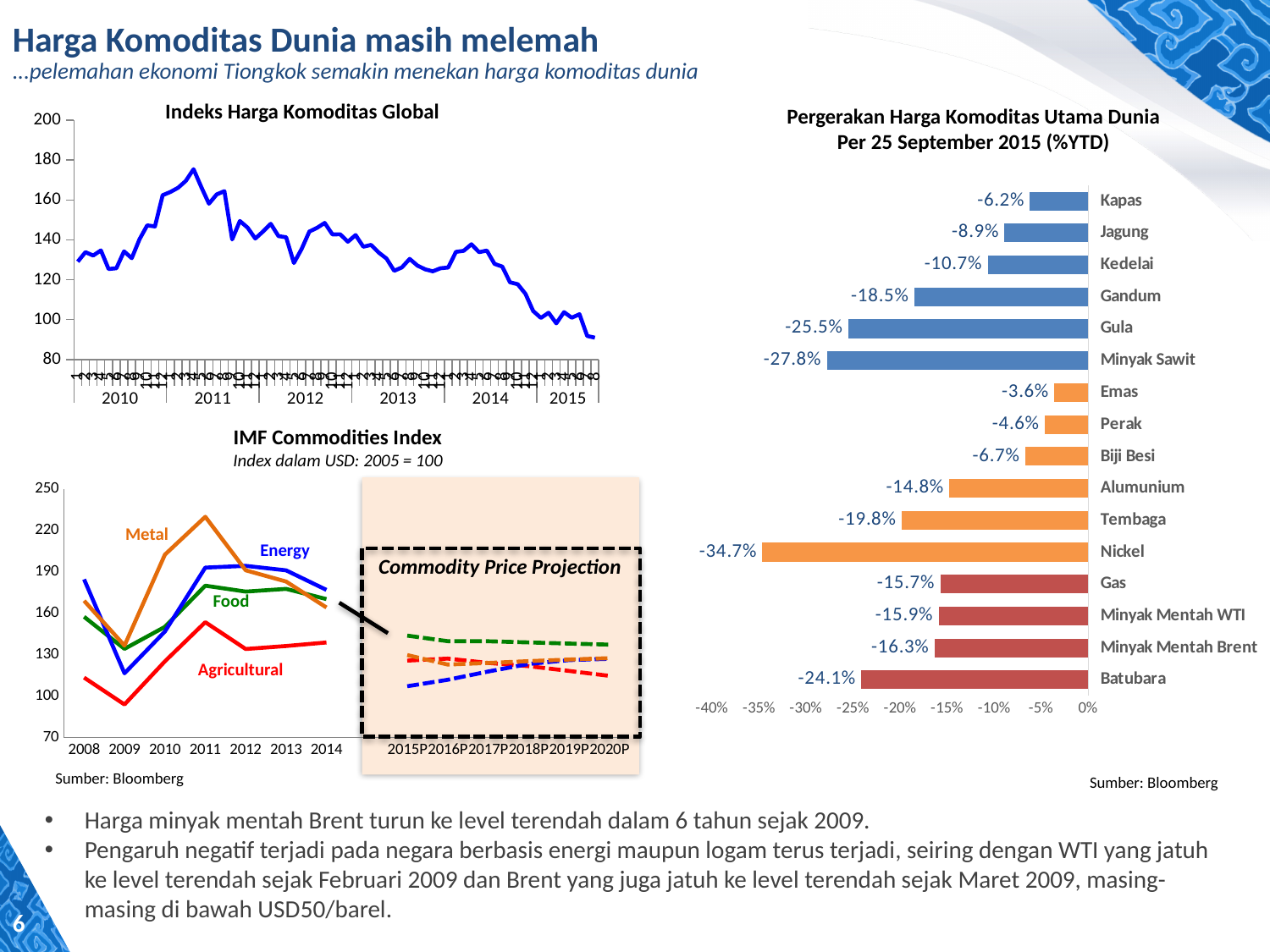
What type of chart is 'Pergerakan Harga Komoditas Utama Dunia Per 25 September 2015 (%YTD)'? Bar chart How many series are plotted on the 'IMF Commodities Index' chart? 4 On the chart 'Pergerakan Harga Komoditas Utama Dunia Per 25 September 2015 (%YTD)', what is the value for Gula? -25.5% On the chart 'Pergerakan Harga Komoditas Utama Dunia Per 25 September 2015 (%YTD)', what is the value for Minyak Mentah Brent? -16.3% On the chart 'Indeks Harga Komoditas Global', does the index rise or fall from 2014 to 2015? fall On the chart 'Pergerakan Harga Komoditas Utama Dunia Per 25 September 2015 (%YTD)', which declined more, Batubara or Gas? Batubara On the chart 'Indeks Harga Komoditas Global', is the last value in 2015 greater or less than 100? less How many commodities are shown on the chart 'Pergerakan Harga Komoditas Utama Dunia Per 25 September 2015 (%YTD)'? 16 On the chart 'Pergerakan Harga Komoditas Utama Dunia Per 25 September 2015 (%YTD)', which commodity has the lowest value (largest decline)? Nickel On the chart 'Pergerakan Harga Komoditas Utama Dunia Per 25 September 2015 (%YTD)', what is the value for Nickel? -34.7% On the chart 'Pergerakan Harga Komoditas Utama Dunia Per 25 September 2015 (%YTD)', what is the difference in percentage points between Minyak Sawit and Kapas? 21.6 percentage points On the chart 'Pergerakan Harga Komoditas Utama Dunia Per 25 September 2015 (%YTD)', which commodity has the highest value (smallest decline)? Emas